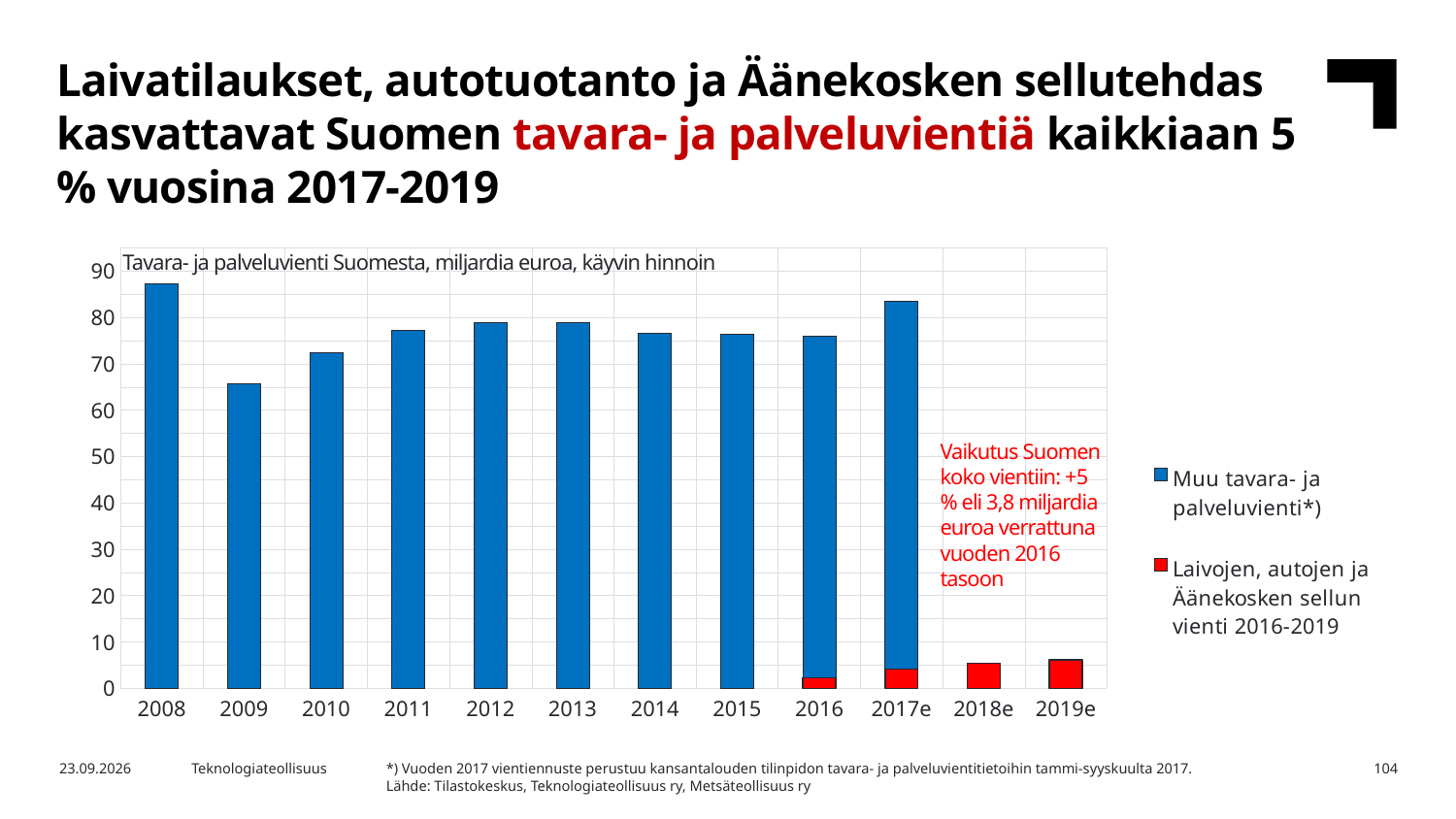
What kind of chart is shown on the slide? Bar chart Is the value for 2008 greater or less than 80? greater What is the title of the chart? Tavara- ja palveluvienti Suomesta, miljardia euroa, käyvin hinnoin Among the years 2008 to 2017e, which year has the lowest total bar? 2009 Is the value for 2010 greater or less than 70? greater Does the total value rise or fall from 2008 to 2009? Fall Is the total value for 2017e greater or less than 80? greater How many year categories are shown on the x axis of the chart? 12 How many series does the chart legend list? 2 Which is larger, the total bar for 2012 or the total bar for 2009? 2012 Which year has the highest total bar in the chart? 2008